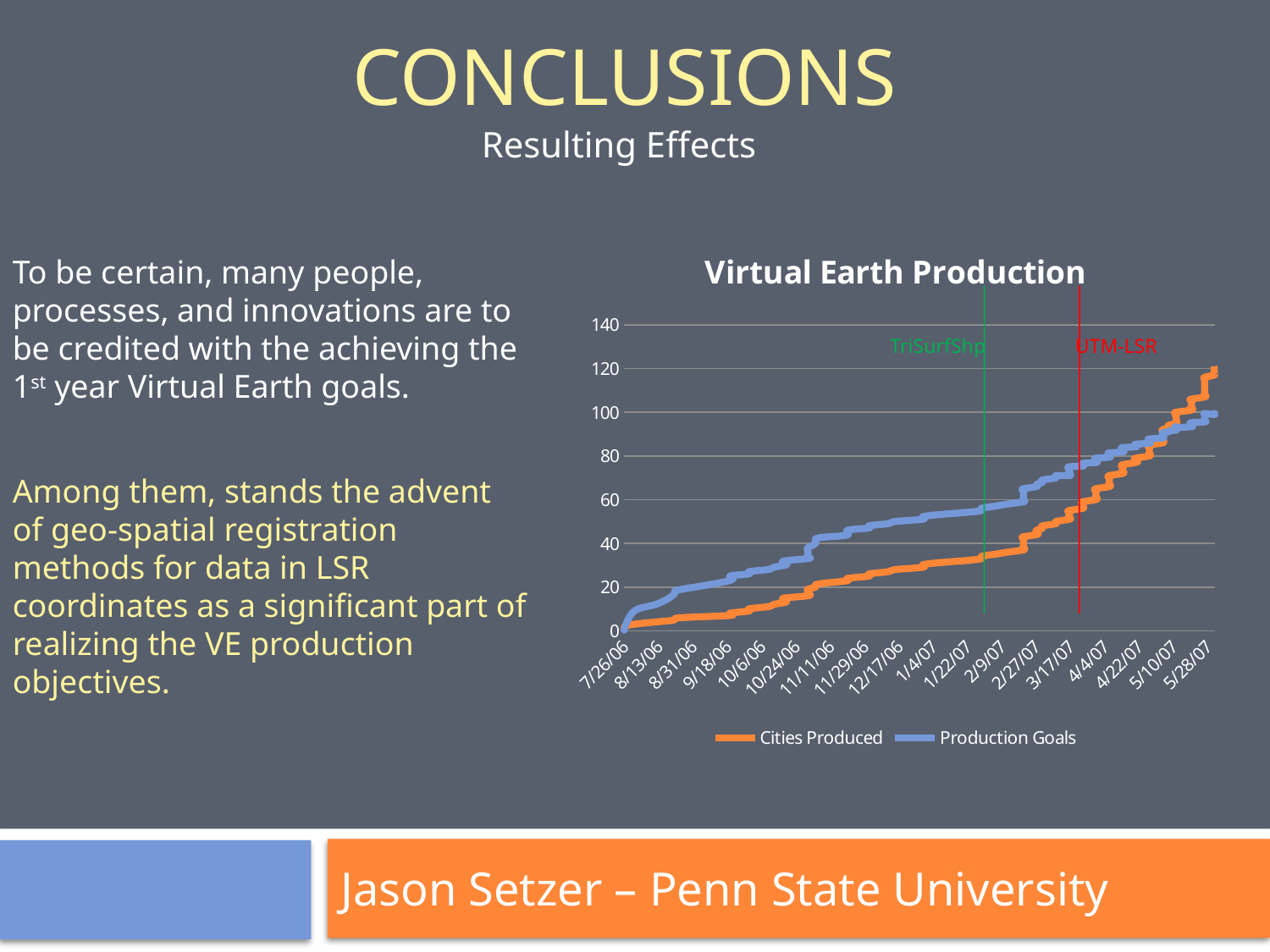
Is the value for Production Goals at 1/22/07 greater or less than 40? greater Is the value for Cities Produced at 5/28/07 greater or less than 100? greater What are the two series named in the legend of the Virtual Earth Production chart? Cities Produced and Production Goals At 2/9/07, which series has the higher value, Cities Produced or Production Goals? Production Goals Is the value for Cities Produced at 1/22/07 greater or less than 40? less What are the labels on the two vertical marker lines in the Virtual Earth Production chart? TriSurfShp and UTM-LSR What kind of chart is shown on the slide? Line chart Do the values of the Production Goals series rise or fall along the x axis? Rise How many series does the legend of the Virtual Earth Production chart list? 2 Do the values of the Cities Produced series rise or fall along the x axis? Rise How many date labels are shown on the x axis of the Virtual Earth Production chart? 18